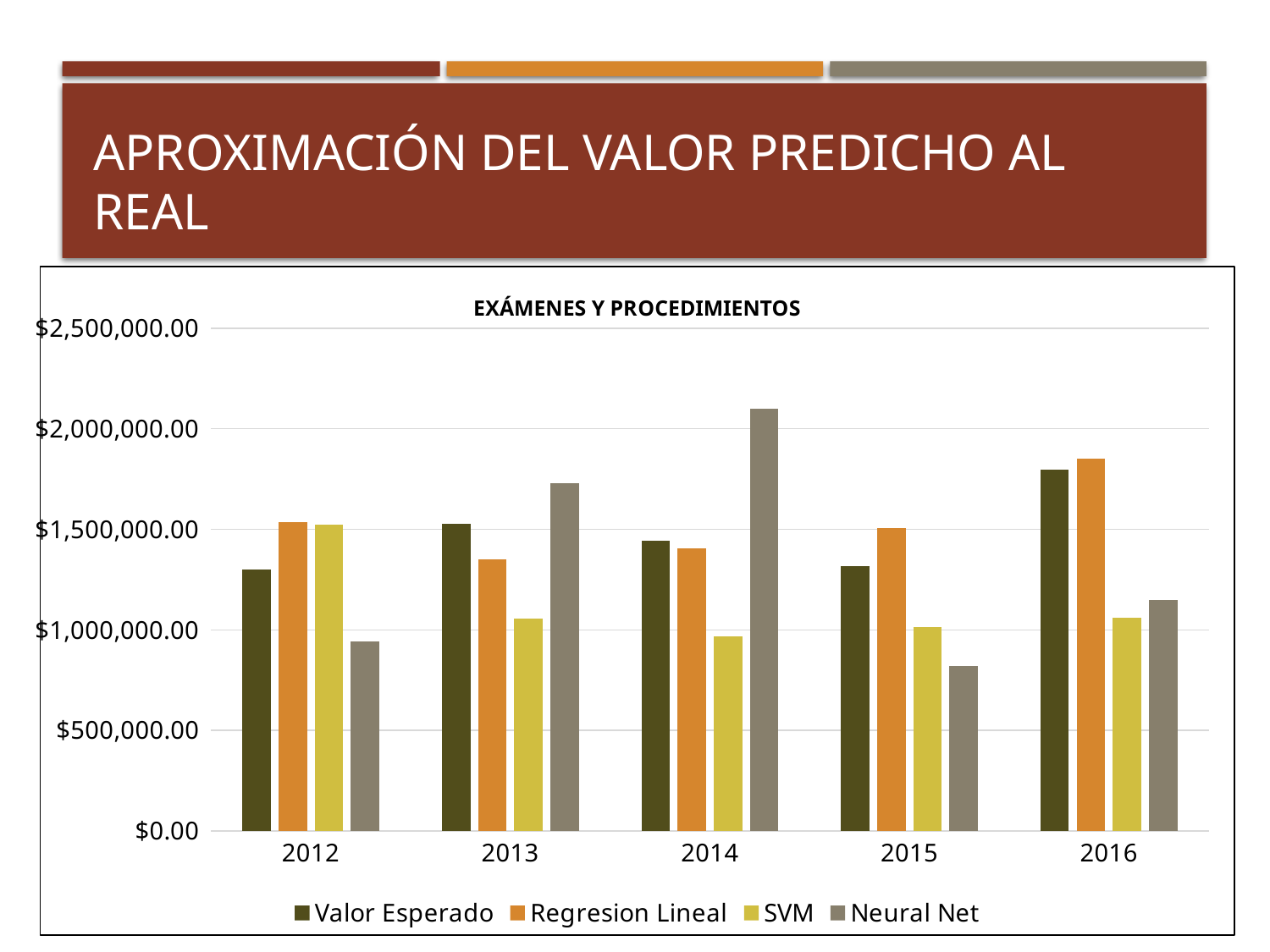
Is the Valor Esperado value for 2016 greater or less than $1,500,000.00? greater What kind of chart is shown on the slide? bar chart In which year is the Neural Net value lowest? 2015 What is the title of the chart? EXÁMENES Y PROCEDIMIENTOS How many series does the legend list? 4 In which year is the Neural Net value highest? 2014 In which year is the Valor Esperado value highest? 2016 Is the SVM value for 2014 greater or less than $1,000,000.00? less In 2015, which is larger: Regresion Lineal or Valor Esperado? Regresion Lineal How many years are shown on the x axis? 5 In 2013, which is larger: Neural Net or Valor Esperado? Neural Net Is the Neural Net value for 2014 greater or less than $2,000,000.00? greater